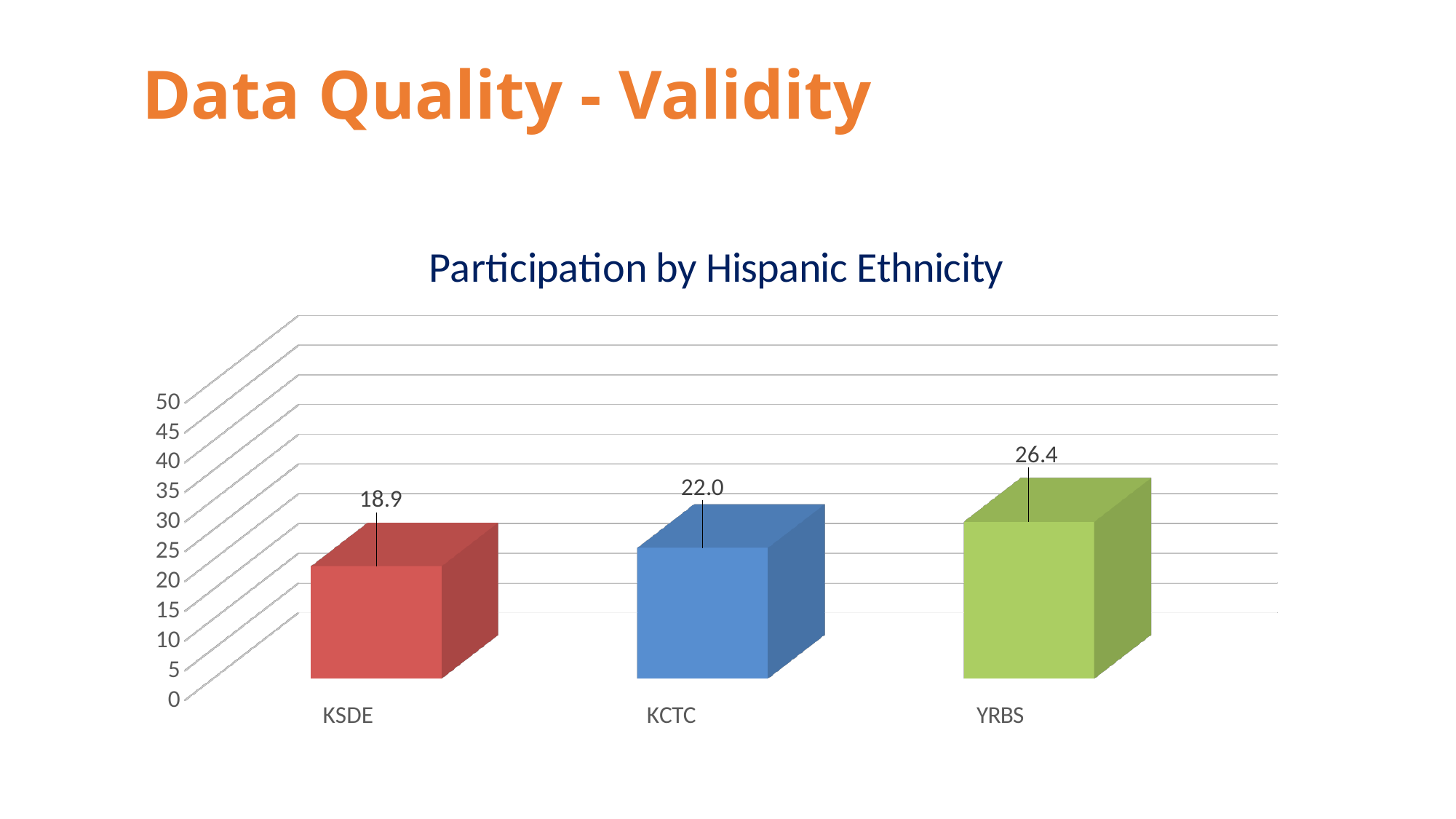
Which is larger, the value for KCTC or the value for KSDE? KCTC What is the value for KSDE? 18.9 What is the value for YRBS? 26.4 How many categories are shown on the x axis? 3 What is the difference between the values for YRBS and KSDE? 7.5 What is the difference between the values for KCTC and KSDE? 3.1 What is the value for KCTC? 22.0 Which category has the highest value? YRBS What kind of chart is shown on the slide? bar chart Which category has the lowest value? KSDE What is the title of the chart? Participation by Hispanic Ethnicity Is the value for YRBS greater or less than 25? greater